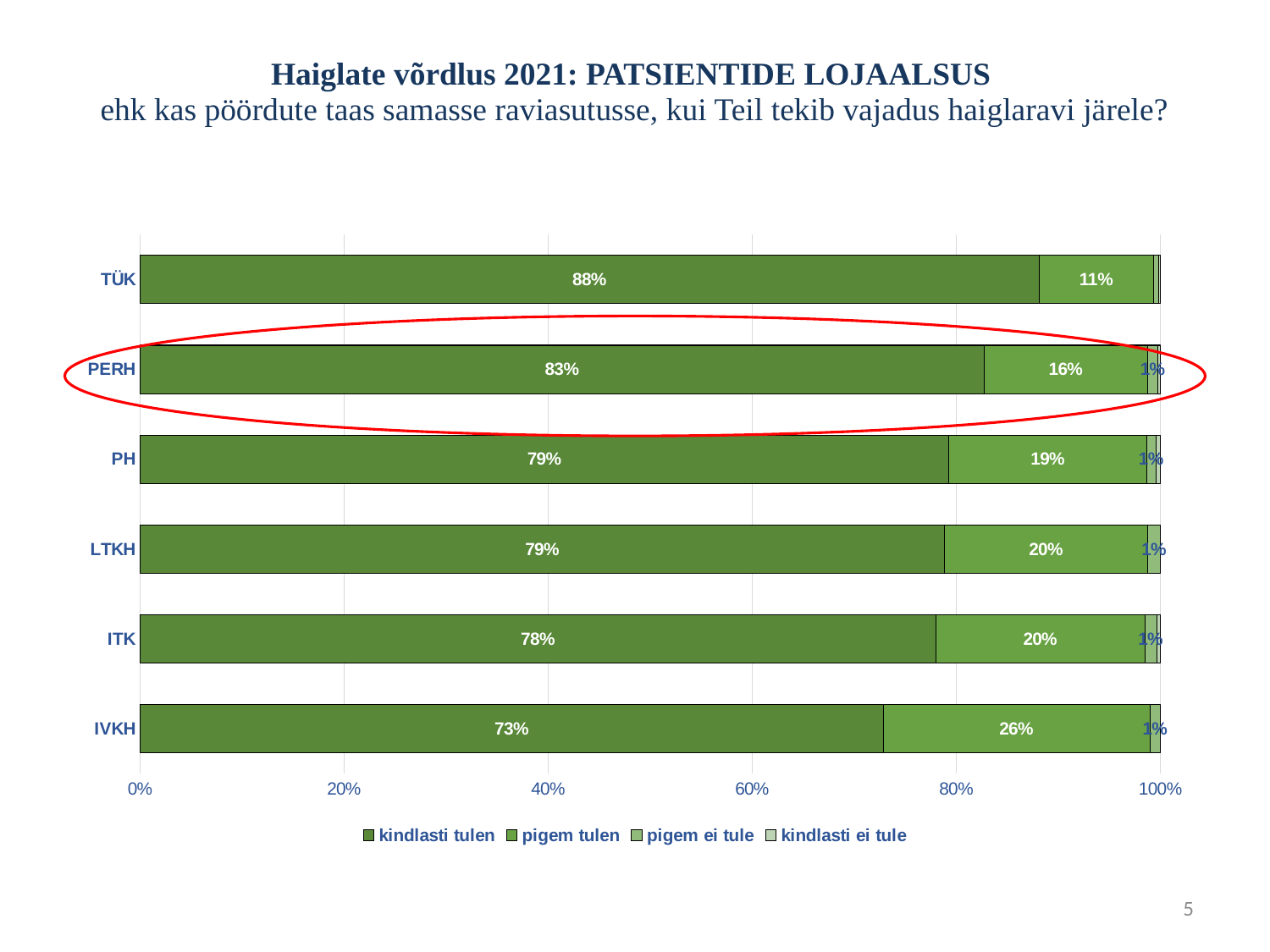
Which has a larger "pigem tulen" value, PH or IVKH? IVKH How many series does the legend list? 4 What is the "pigem tulen" value for IVKH? 26% What is the "pigem tulen" value for PERH? 16% What is the difference between the "kindlasti tulen" values for TÜK and IVKH? 15% How many hospitals are shown on the chart? 6 Is the "kindlasti tulen" value for ITK greater or less than 60%? greater Which hospital has the highest "kindlasti tulen" value? TÜK What is the "kindlasti tulen" value for TÜK? 88% What kind of chart is shown on the slide? Stacked bar chart Which hospital is circled in red on the chart? PERH Which hospital has the lowest "kindlasti tulen" value? IVKH